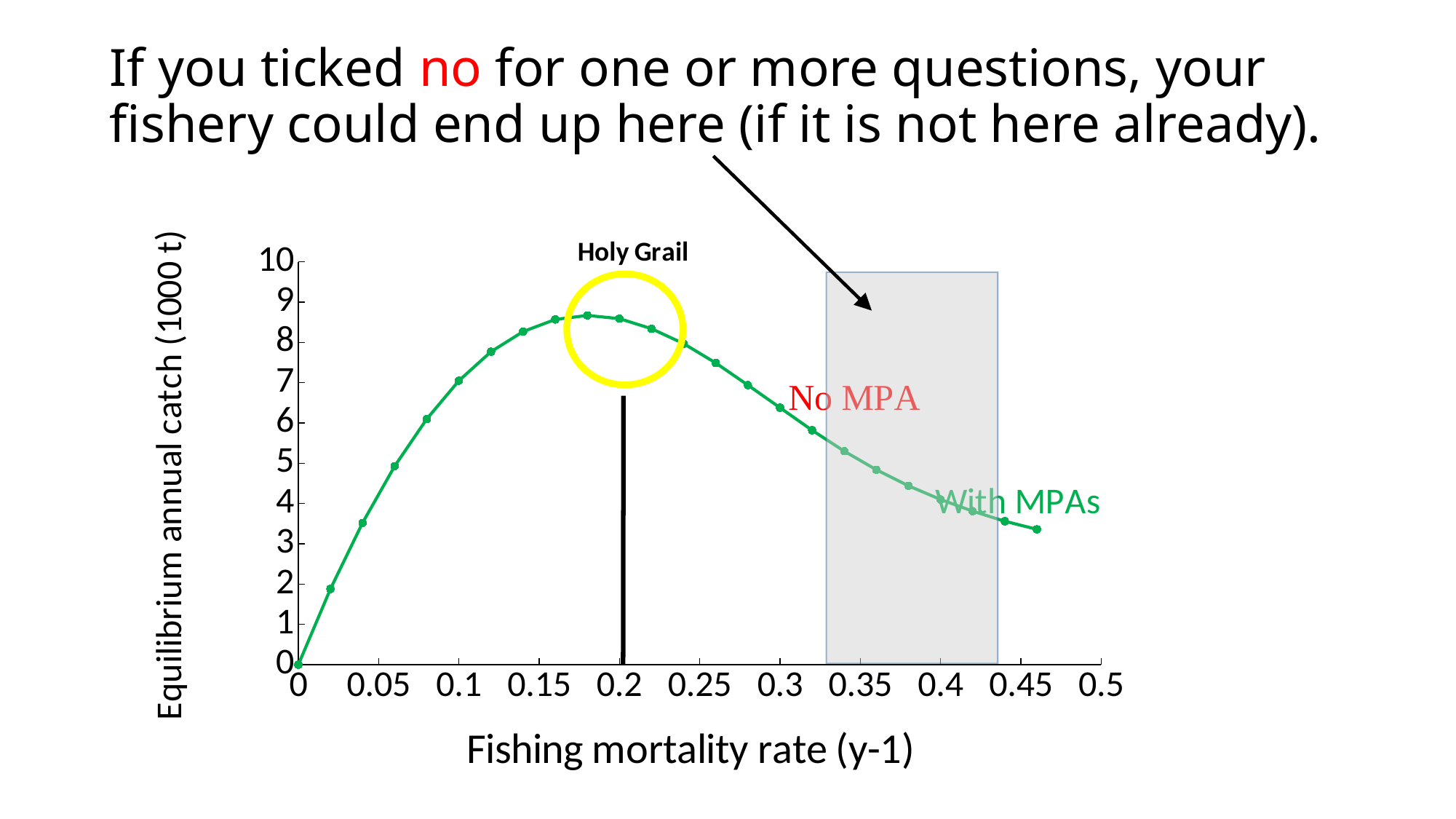
What is the equilibrium annual catch when the fishing mortality rate is 0? 0 Which has the higher equilibrium annual catch: a fishing mortality rate of 0.2 or 0.45? 0.2 How does the equilibrium annual catch change as the fishing mortality rate increases from 0.2 to 0.45? it falls Which has the higher equilibrium annual catch: a fishing mortality rate of 0.1 or 0.4? 0.1 Is the equilibrium annual catch at a fishing mortality rate of 0.15 greater or less than 8? greater Is the equilibrium annual catch at a fishing mortality rate of 0.35 greater or less than 6? less What label is written above the yellow circle marking the peak of the curve? Holy Grail Is the equilibrium annual catch at a fishing mortality rate of 0.3 greater or less than 6? greater What kind of chart is shown on the slide? line chart What is the label of the y axis? Equilibrium annual catch (1000 t)